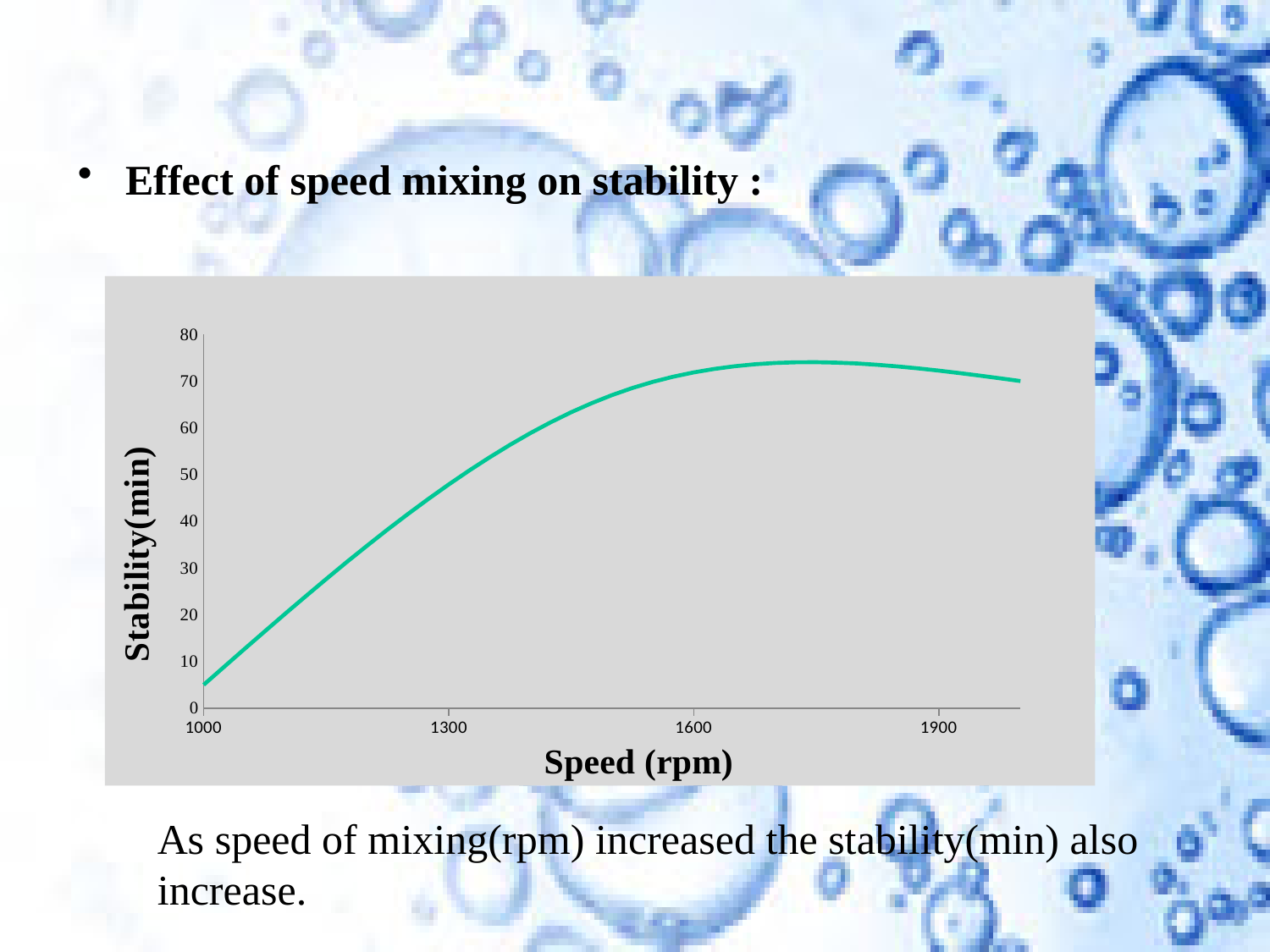
Does stability rise or fall as speed increases from 1000 rpm to 1600 rpm? rise Is the stability at 1600 rpm higher or lower than the stability at 1300 rpm? higher What is the title of the y axis of the chart? Stability(min) What is the title of the x axis of the chart? Speed (rpm) Is the stability value at a speed of 1300 rpm greater or less than 60? less Is the stability value at a speed of 1900 rpm greater or less than 60? greater Is the stability value at a speed of 1300 rpm greater or less than 40? greater Is the stability at 1000 rpm higher or lower than the stability at 1900 rpm? lower What kind of chart is shown on the slide? line chart What is the highest value shown on the y axis of the chart? 80